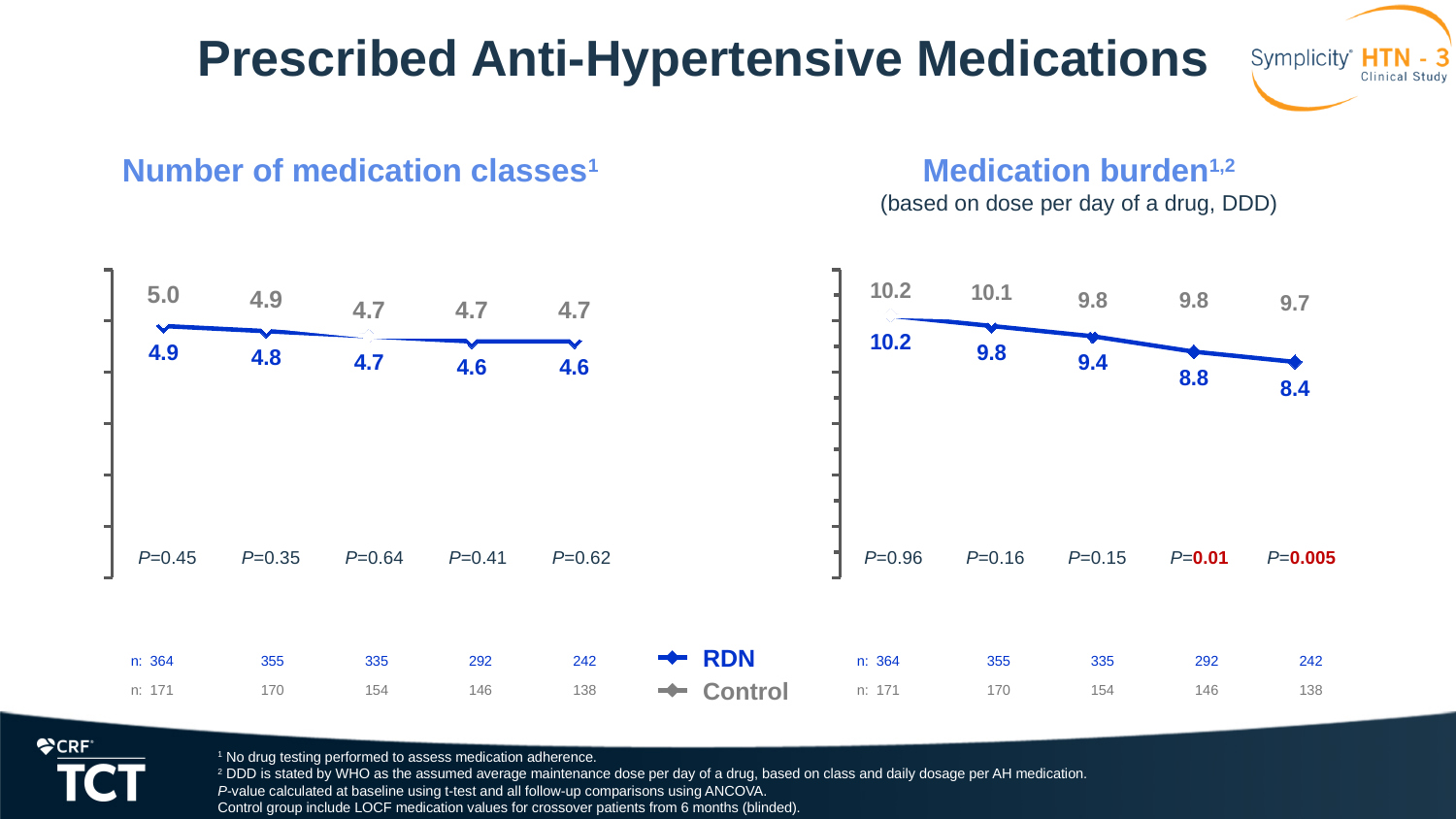
In the "Medication burden" chart, what is the Control value at the first data point? 10.2 How many data points does each series have in the "Number of medication classes" chart? 5 How many series does the legend list? 2 Which colour is used for the RDN series? blue In the "Medication burden" chart, what is the difference between the Control and RDN values at the last data point? 1.3 In the "Medication burden" chart, what is the RDN value at the last data point? 8.4 In the "Medication burden" chart, what is the lowest RDN value shown? 8.4 In the "Medication burden" chart, does the RDN series rise or fall from the first to the last data point? fall In the "Number of medication classes" chart, what is the Control value at the first data point? 5.0 In the "Number of medication classes" chart, what is the RDN value at the last data point? 4.6 What kind of chart is used for "Number of medication classes"? line chart In the "Medication burden" chart, which series has the lower value at the fourth data point, RDN or Control? RDN